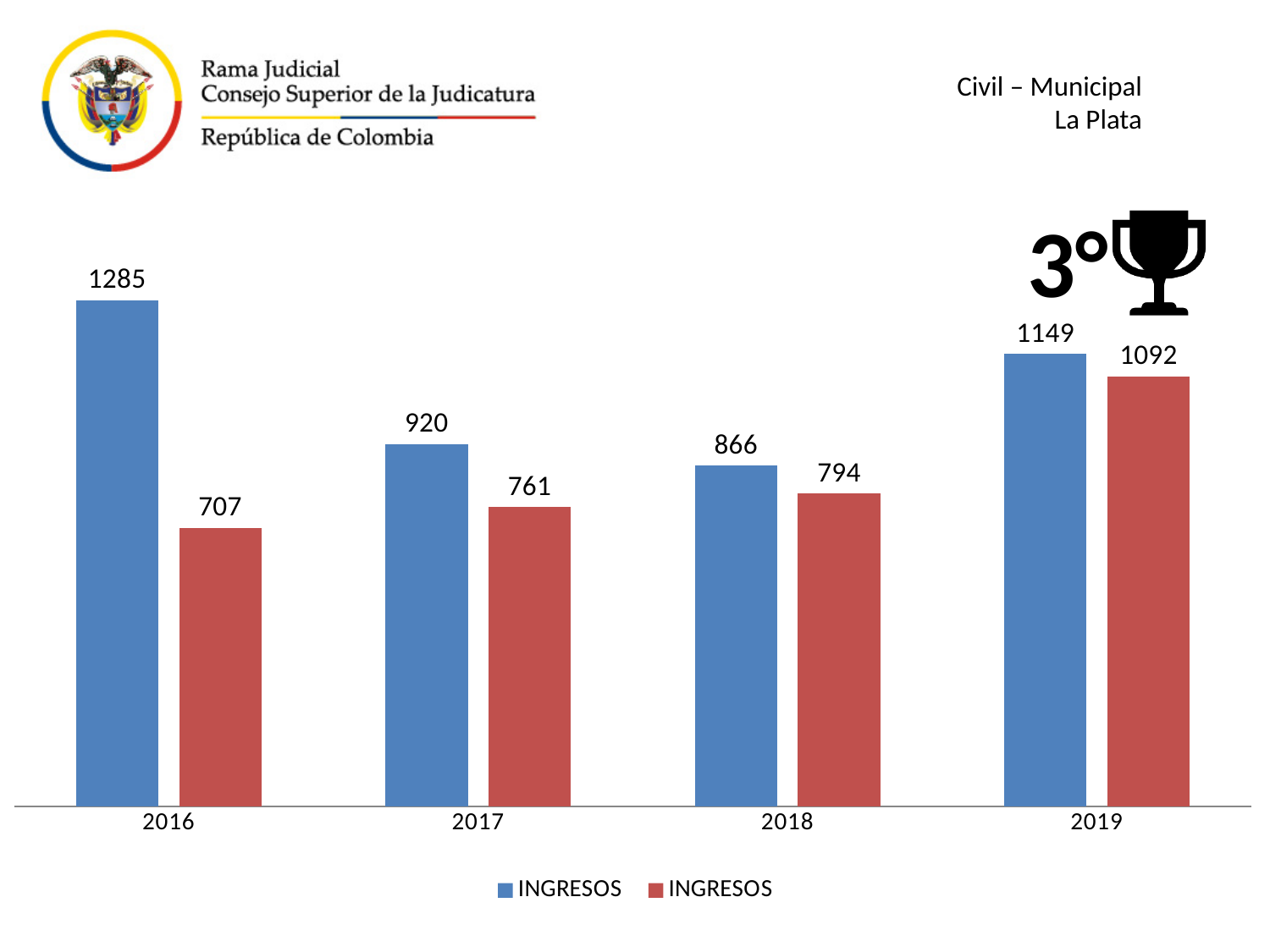
What is the value of the blue bar for 2016? 1285 How many years are shown on the x axis? 4 Which year has the highest blue bar? 2016 Which is larger, the red bar for 2018 or the red bar for 2017? 2018 How many series does the legend list? 2 What is the value of the blue bar for 2018? 866 What is the difference between the blue bars for 2019 and 2018? 283 What kind of chart is shown on the slide? bar chart What is the value of the red bar for 2017? 761 What is the difference between the blue and red bars for 2016? 578 What is the value of the red bar for 2019? 1092 Which year has the lowest red bar? 2016